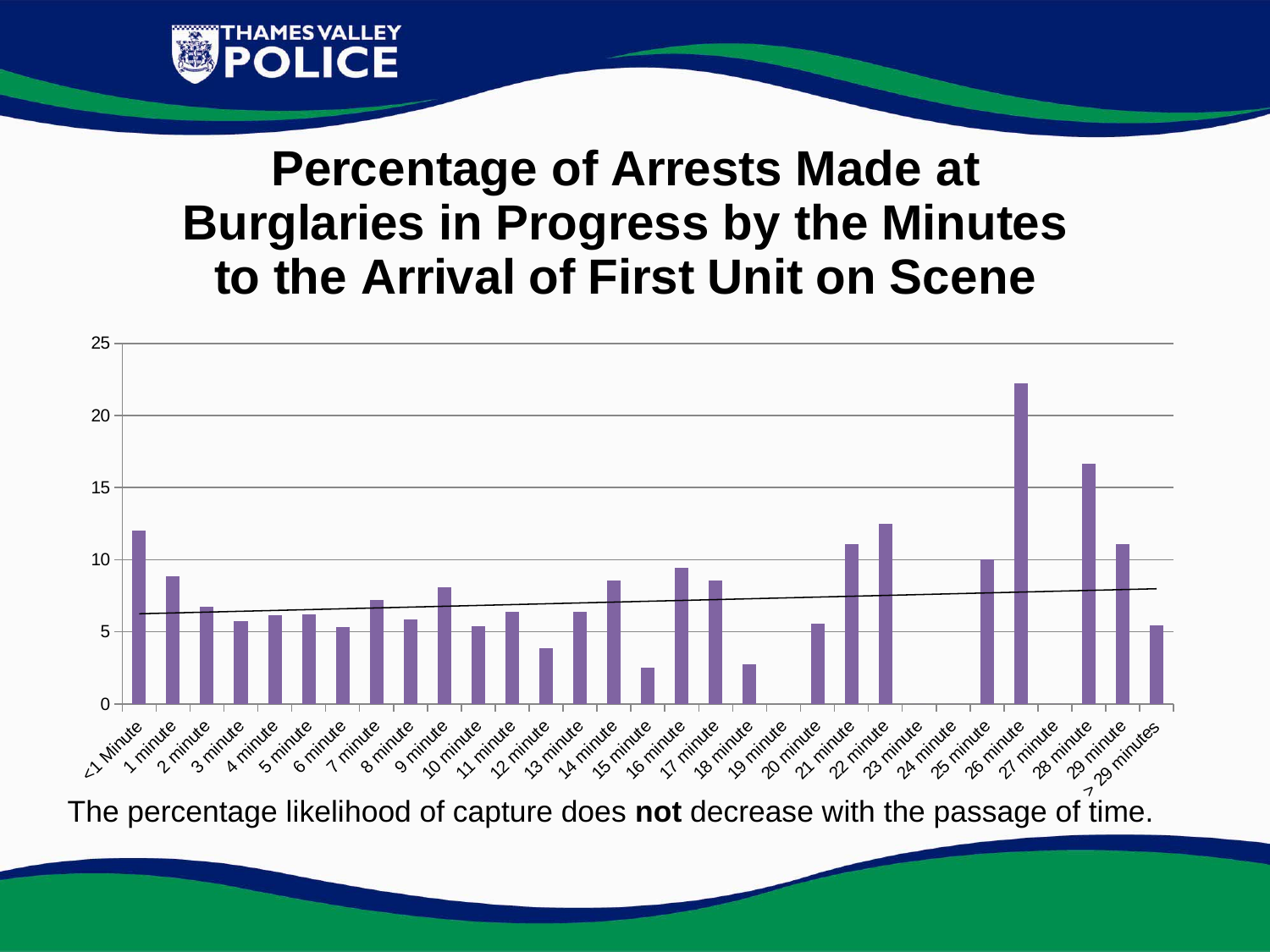
According to the text below the chart, does the percentage likelihood of capture decrease with the passage of time? No Is the value for 18 minute greater or less than 5? less Which is larger, the value for 26 minute or the value for 28 minute? 26 minute Is the value for 26 minute greater or less than 20? greater How many categories are shown along the x axis? 31 Which is larger, the value for <1 Minute or the value for 1 minute? <1 Minute Which category has the highest percentage of arrests? 26 minute What is the highest value shown on the y axis? 25 Is the value for <1 Minute greater or less than 10? greater What kind of chart is shown on the slide? bar chart